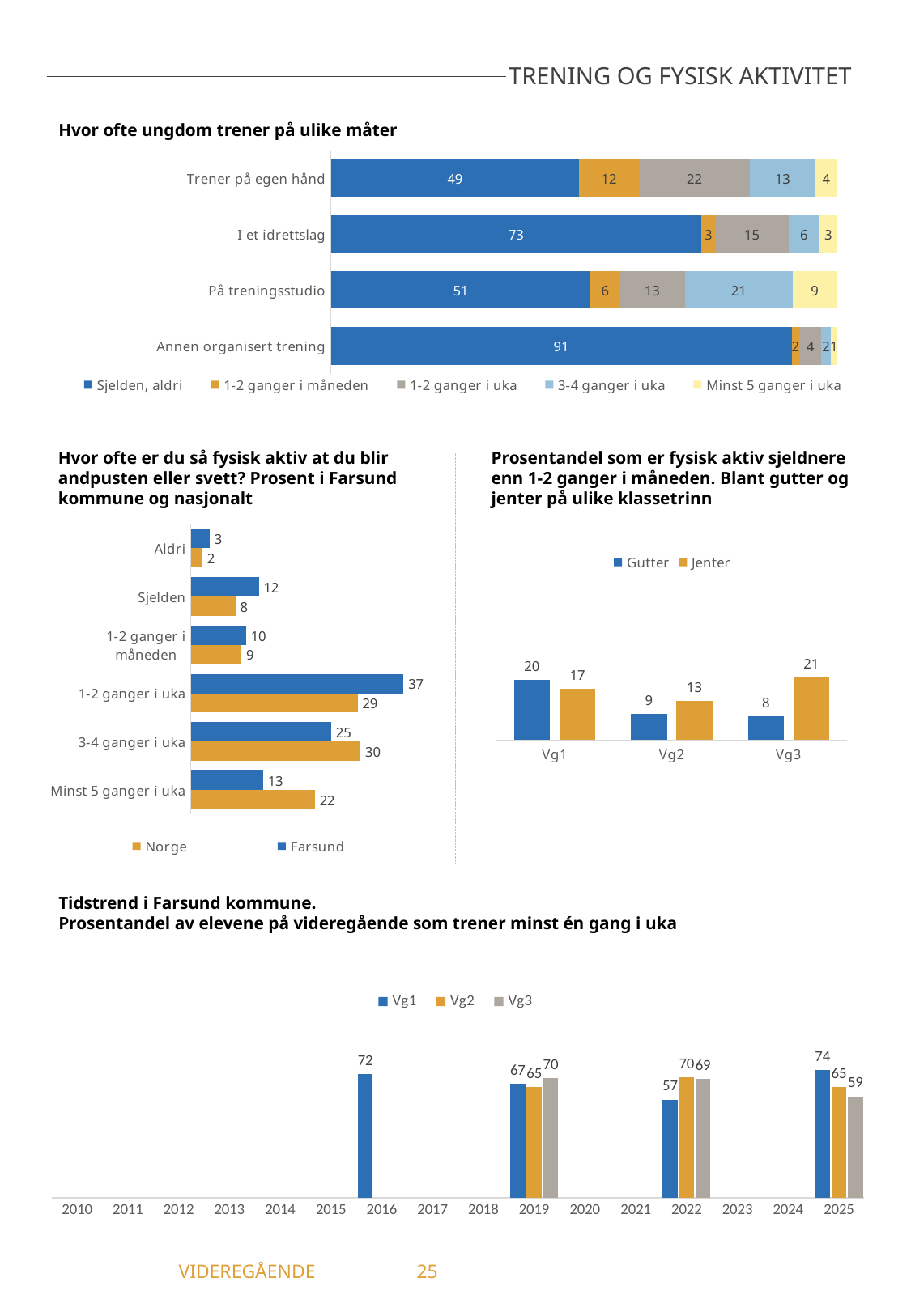
In the chart 'Hvor ofte ungdom trener på ulike måter', what is the value for 'Sjelden, aldri' for 'I et idrettslag'? 73 In the chart 'Hvor ofte ungdom trener på ulike måter', what is the value for '3-4 ganger i uka' for 'På treningsstudio'? 21 In the chart 'Hvor ofte er du så fysisk aktiv at du blir andpusten eller svett?', which is larger for '3-4 ganger i uka', Norge or Farsund? Norge In the chart 'Hvor ofte er du så fysisk aktiv at du blir andpusten eller svett?', how many categories are shown? 6 In the chart 'Hvor ofte ungdom trener på ulike måter', what is the total of the stacked bar for 'Trener på egen hånd'? 100 In the chart 'Hvor ofte ungdom trener på ulike måter', how many series does the legend list? 5 In the chart 'Tidstrend i Farsund kommune', which year has the highest value for Vg1? 2025 In the chart 'Hvor ofte er du så fysisk aktiv at du blir andpusten eller svett?', what is the value for Farsund for '1-2 ganger i uka'? 37 In the chart 'Hvor ofte er du så fysisk aktiv at du blir andpusten eller svett?', what is the difference between Norge and Farsund for 'Minst 5 ganger i uka'? 9 In the chart 'Prosentandel som er fysisk aktiv sjeldnere enn 1-2 ganger i måneden', which class level has the lowest value for Gutter? Vg3 In the chart 'Prosentandel som er fysisk aktiv sjeldnere enn 1-2 ganger i måneden', what is the value for Jenter at Vg3? 21 In the chart 'Tidstrend i Farsund kommune', what is the value for Vg1 in 2022? 57